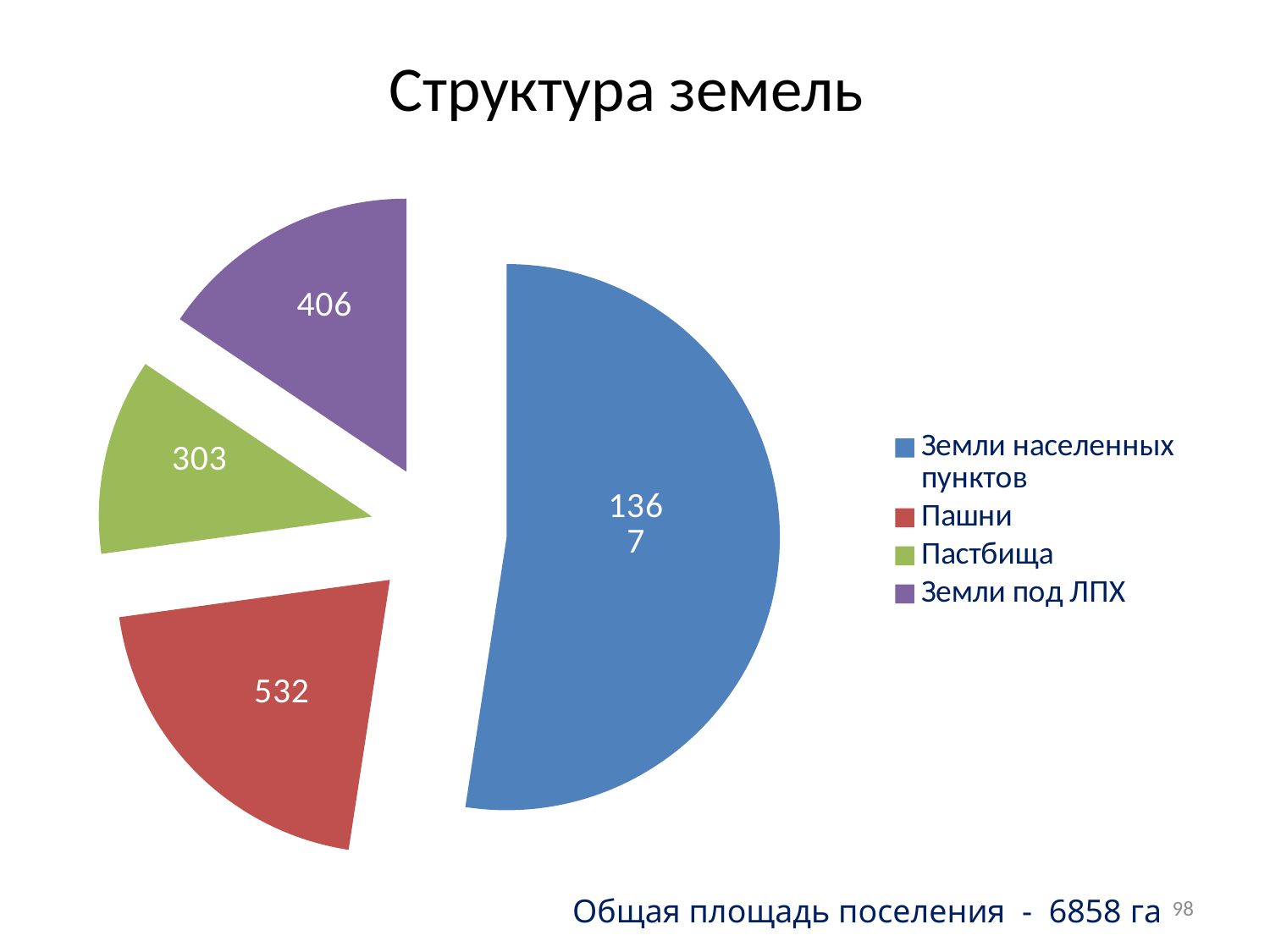
What is the title of the chart? Структура земель What is the difference between the values for Пашни and Земли под ЛПХ? 126 What is the value for Пашни? 532 Which is larger, the value for Земли под ЛПХ or the value for Пастбища? Земли под ЛПХ How many slices does the pie chart have? 4 What is the value for Земли населенных пунктов? 1367 What is the value for Пастбища? 303 How many entries does the legend list? 4 Which category has the smallest slice? Пастбища What is the value for Земли под ЛПХ? 406 What type of chart is shown on the slide? pie chart Which category has the largest slice? Земли населенных пунктов